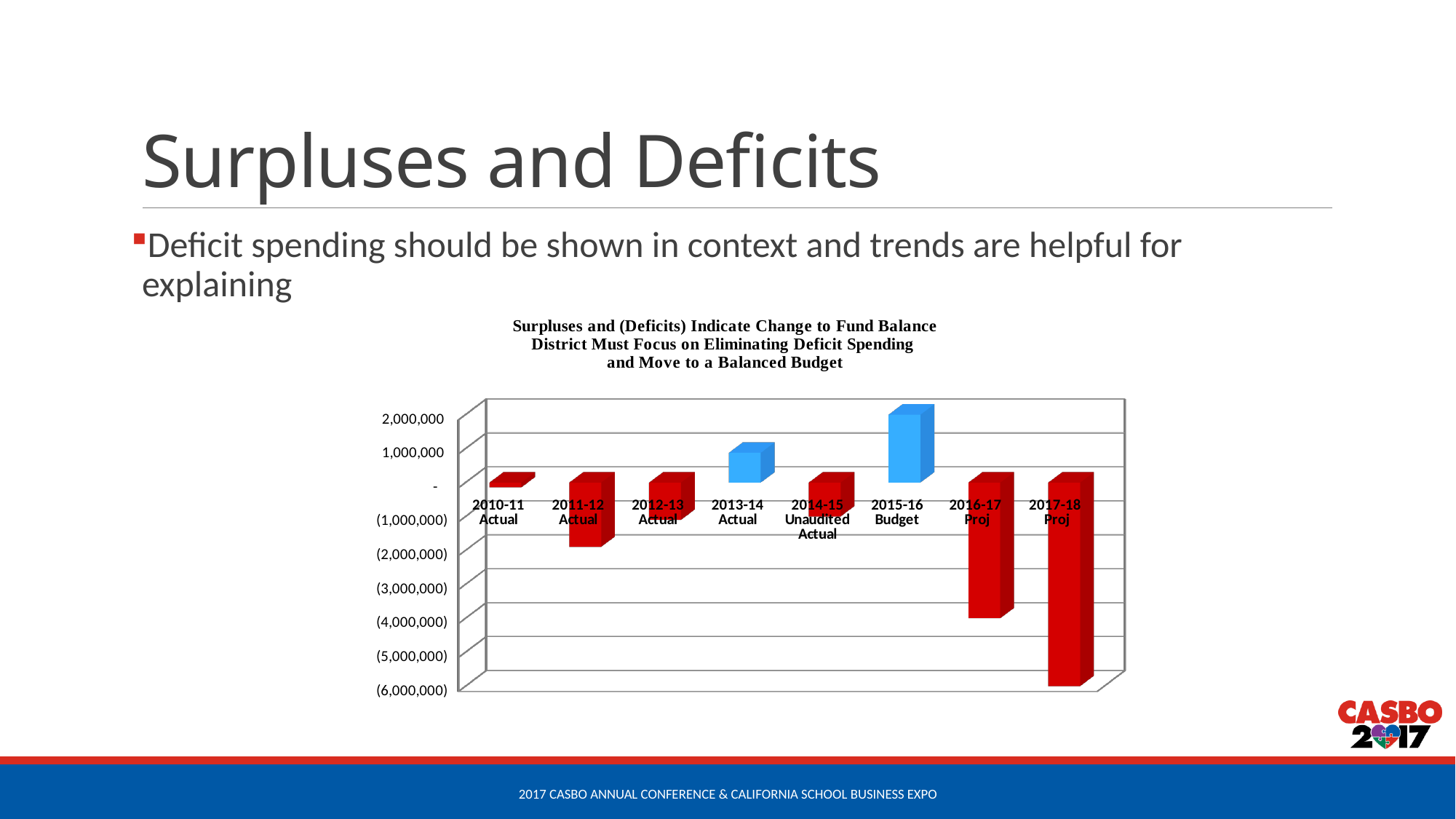
Which is larger, the value for 2016-17 Proj or the value for 2017-18 Proj? 2016-17 Proj Which category has the lowest value on the chart? 2017-18 Proj Is the value for 2015-16 Budget greater or less than 1,000,000? greater Which category has the highest value on the chart? 2015-16 Budget Is the value for 2017-18 Proj greater or less than (5,000,000)? less Which is larger, the value for 2013-14 Actual or the value for 2015-16 Budget? 2015-16 Budget How many categories on the chart show a surplus (a bar above zero)? 2 What kind of chart is shown on the slide? bar chart Is the value for 2016-17 Proj greater or less than (3,000,000)? less What colour are the bars representing deficits on the chart? red How many fiscal-year categories are plotted on the chart? 8